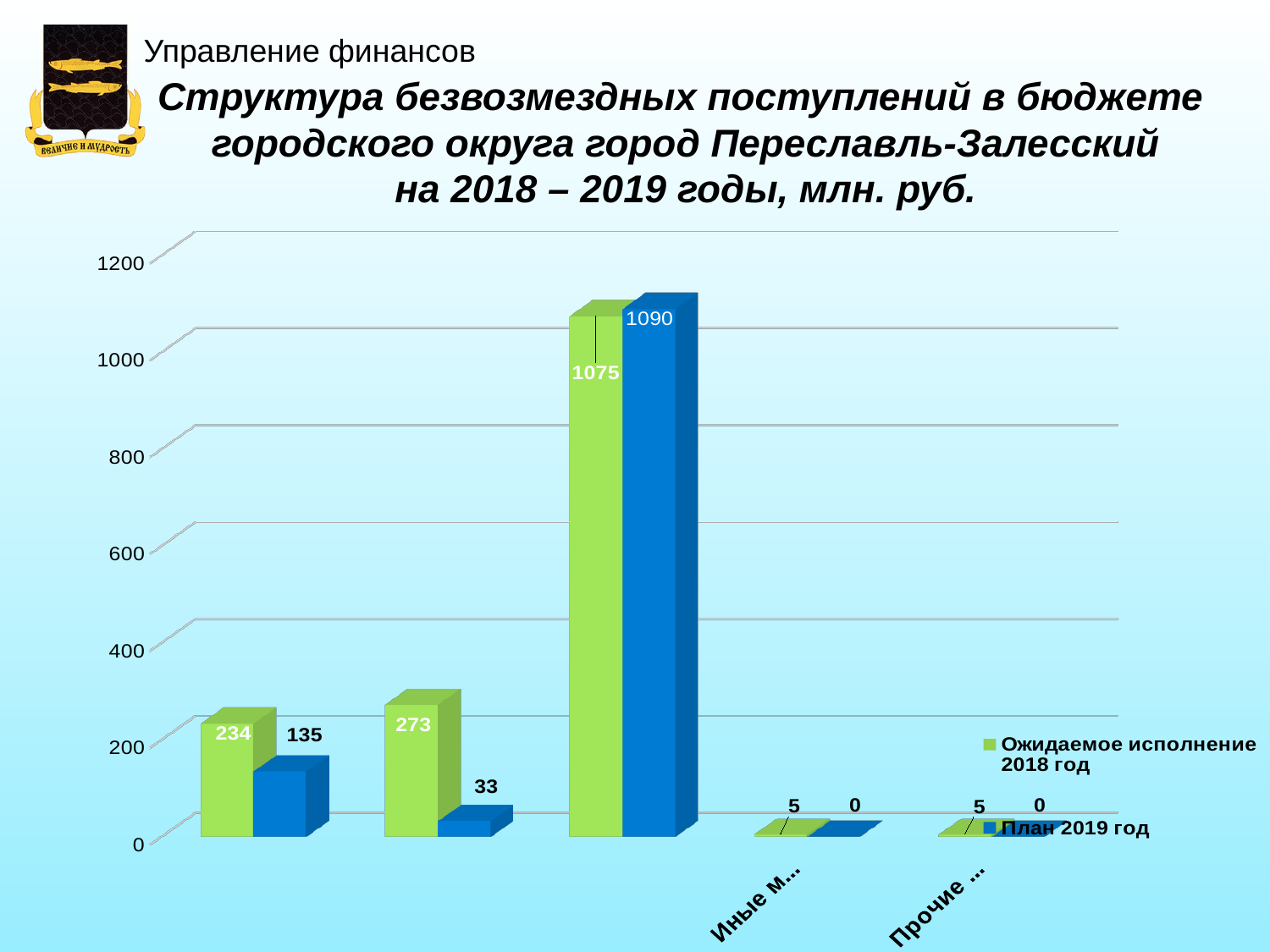
What is the value of the 'Ожидаемое исполнение 2018 год' bar in the third group from the left (the tallest group)? 1075 What is the highest value shown for the 'План 2019 год' series? 1090 What is the value of the 'План 2019 год' bar in the first group from the left? 135 In the second group from the left, which is larger: the 'Ожидаемое исполнение 2018 год' value or the 'План 2019 год' value? Ожидаемое исполнение 2018 год What is the value of the 'Ожидаемое исполнение 2018 год' bar in the second group from the left? 273 What is the difference between the 'Ожидаемое исполнение 2018 год' and 'План 2019 год' values in the first group from the left (234 and 135)? 99 What is the value of the 'План 2019 год' bar in the third group from the left (the tallest group)? 1090 How many series does the legend list? 2 What is the 'План 2019 год' value for the category 'Иные м...'? 0 Which colour represents the 'План 2019 год' series in the legend? blue How many category groups of bars are plotted in the chart? 5 What kind of chart is shown on the slide? bar chart